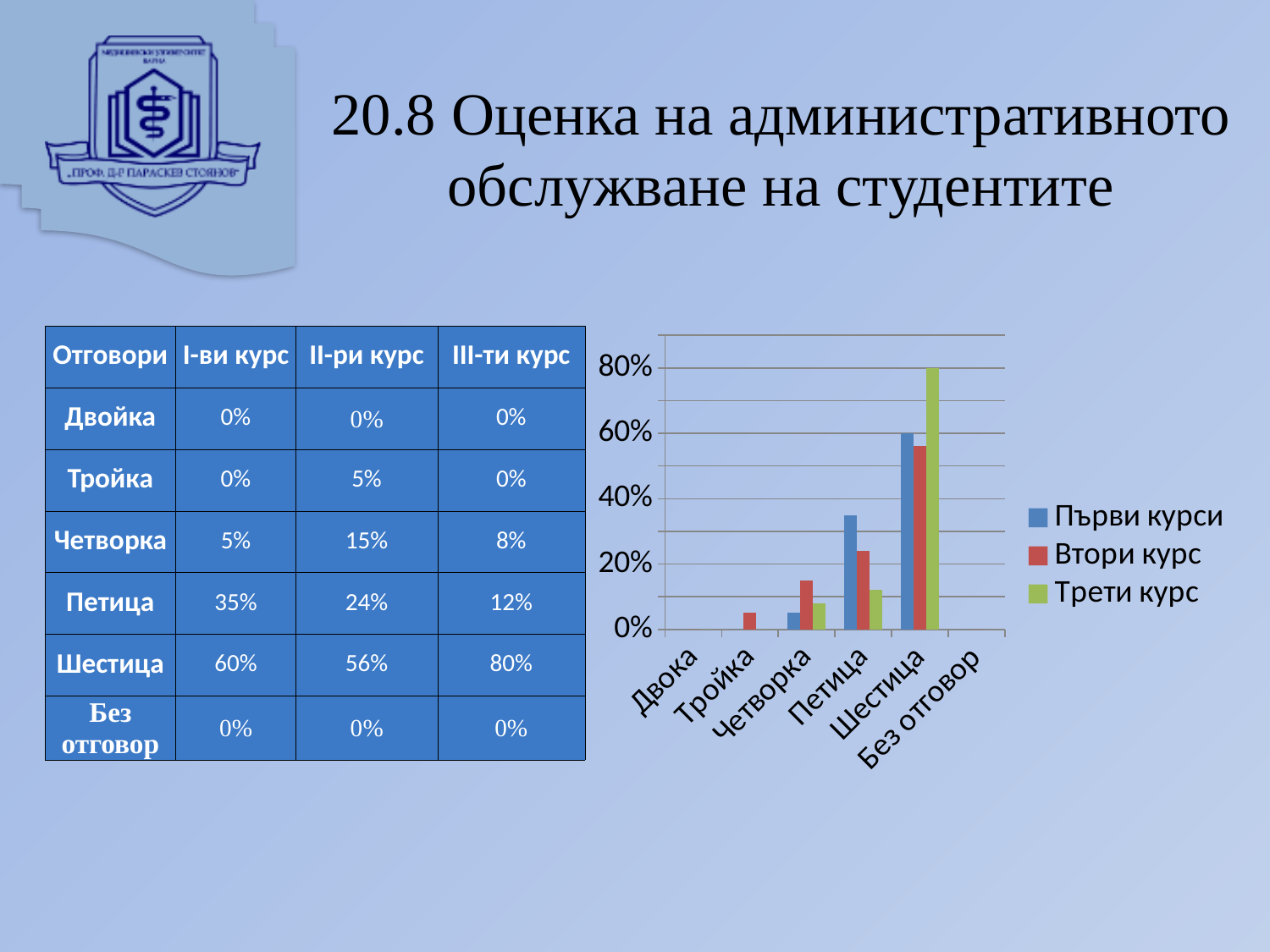
Which colour represents the Трети курс series in the chart? green Is the value for Петица in the Втори курс series greater or less than 40%? less How many categories are shown on the x axis of the chart? 6 What is the difference between the Трети курс and Втори курс values for Шестица? 24% Is the value for Шестица in the Първи курси series greater or less than 40%? greater Which category has the highest value for the Трети курс series? Шестица What kind of chart is shown on the slide? bar chart For Петица, which series has the larger value: Първи курси or Трети курс? Първи курси What is the value for Петица in the Първи курси series? 35% What is the value for Шестица in the Трети курс series? 80% What is the value for Четворка in the Втори курс series? 15% How many series does the chart legend list? 3